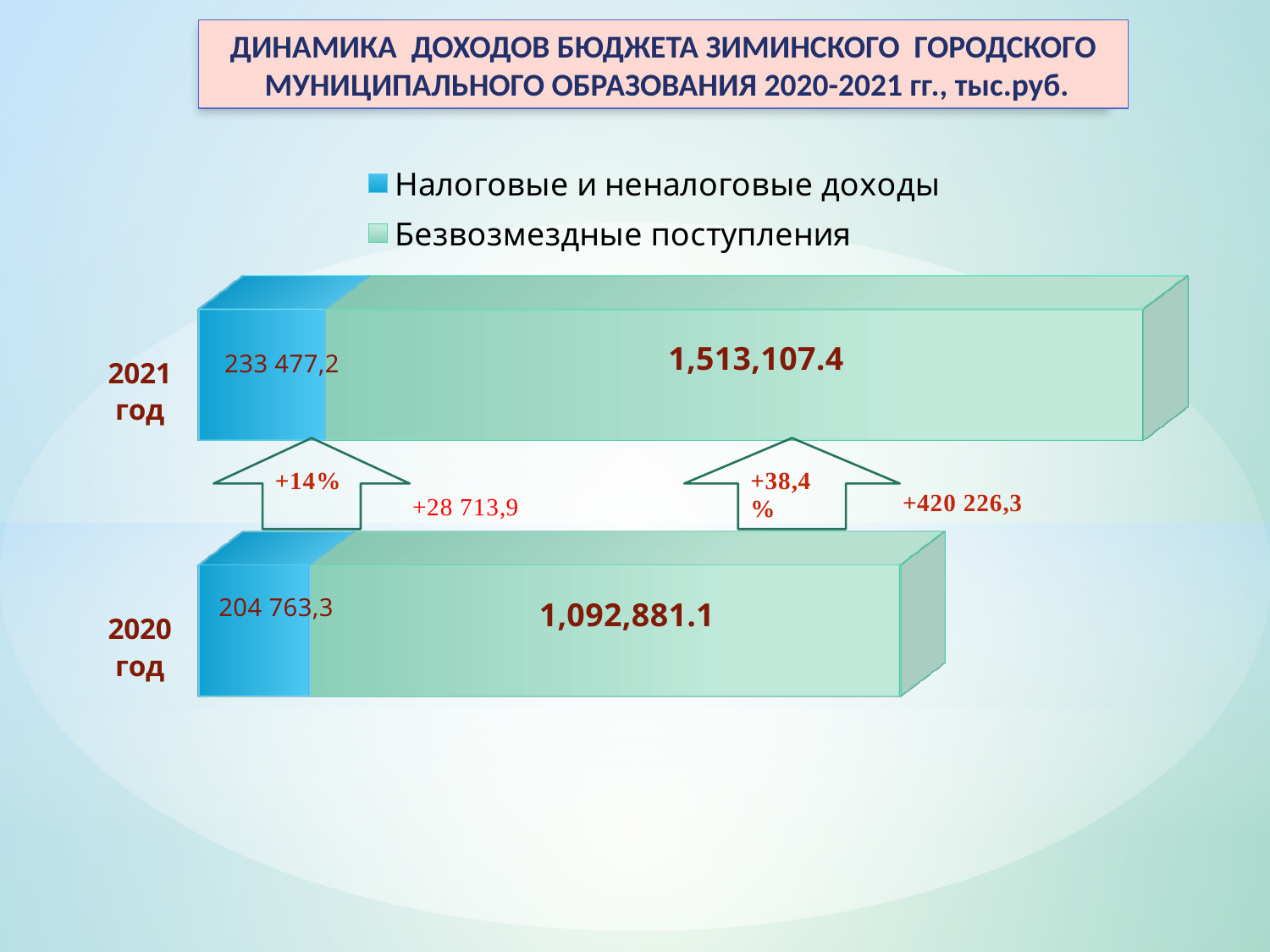
How many series does the legend list? 2 What is the value of Безвозмездные поступления for 2020 год? 1,092,881.1 What kind of chart is shown on the slide? Stacked bar chart Which year has the higher value for Безвозмездные поступления? 2021 год What is the value of Налоговые и неналоговые доходы for 2020 год? 204 763,3 By how much did Безвозмездные поступления increase from 2020 год to 2021 год? 420 226,3 How many years (categories) are shown in the chart? 2 By how much did Налоговые и неналоговые доходы increase from 2020 год to 2021 год? 28 713,9 What is the value of Налоговые и неналоговые доходы for 2021 год? 233 477,2 Which year has the lower value for Налоговые и неналоговые доходы? 2020 год Which is larger in 2021 год: Налоговые и неналоговые доходы or Безвозмездные поступления? Безвозмездные поступления What is the value of Безвозмездные поступления for 2021 год? 1,513,107.4